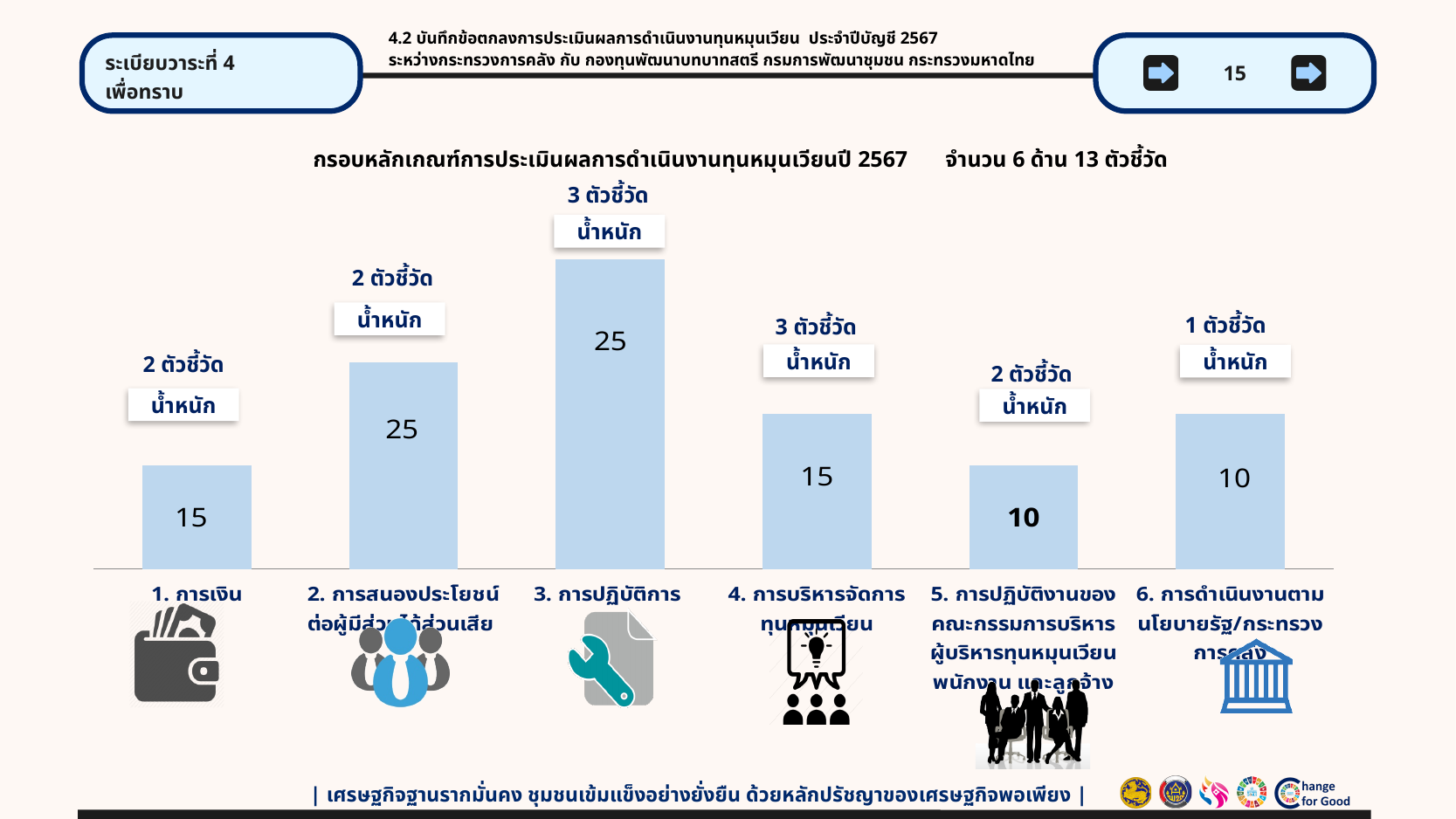
What is the difference between the weight for category 2. การสนองประโยชน์ต่อผู้มีส่วนได้ส่วนเสีย and category 1. การเงิน? 10 According to the chart title, how many indicators (ตัวชี้วัด) are there in total across the 6 areas? 13 ตัวชี้วัด Which has a larger weight: category 4. การบริหารจัดการทุนหมุนเวียน or category 5. การปฏิบัติงานของคณะกรรมการบริหาร ผู้บริหารทุนหมุนเวียน พนักงาน และลูกจ้าง? 4. การบริหารจัดการทุนหมุนเวียน How many indicators (ตัวชี้วัด) are listed for category 6. การดำเนินงานตามนโยบายรัฐ/กระทรวงการคลัง? 1 ตัวชี้วัด What is the weight (น้ำหนัก) value shown for category 1. การเงิน? 15 What is the weight value shown for category 4. การบริหารจัดการทุนหมุนเวียน? 15 How many categories (ด้าน) are shown in the chart? 6 What is the total of all the weight values shown across the six bars? 100 What is the weight value shown for category 3. การปฏิบัติการ? 25 What is the weight value shown for category 6. การดำเนินงานตามนโยบายรัฐ/กระทรวงการคลัง? 10 What kind of chart is shown on the slide? Bar chart How many indicators (ตัวชี้วัด) are listed for category 3. การปฏิบัติการ? 3 ตัวชี้วัด